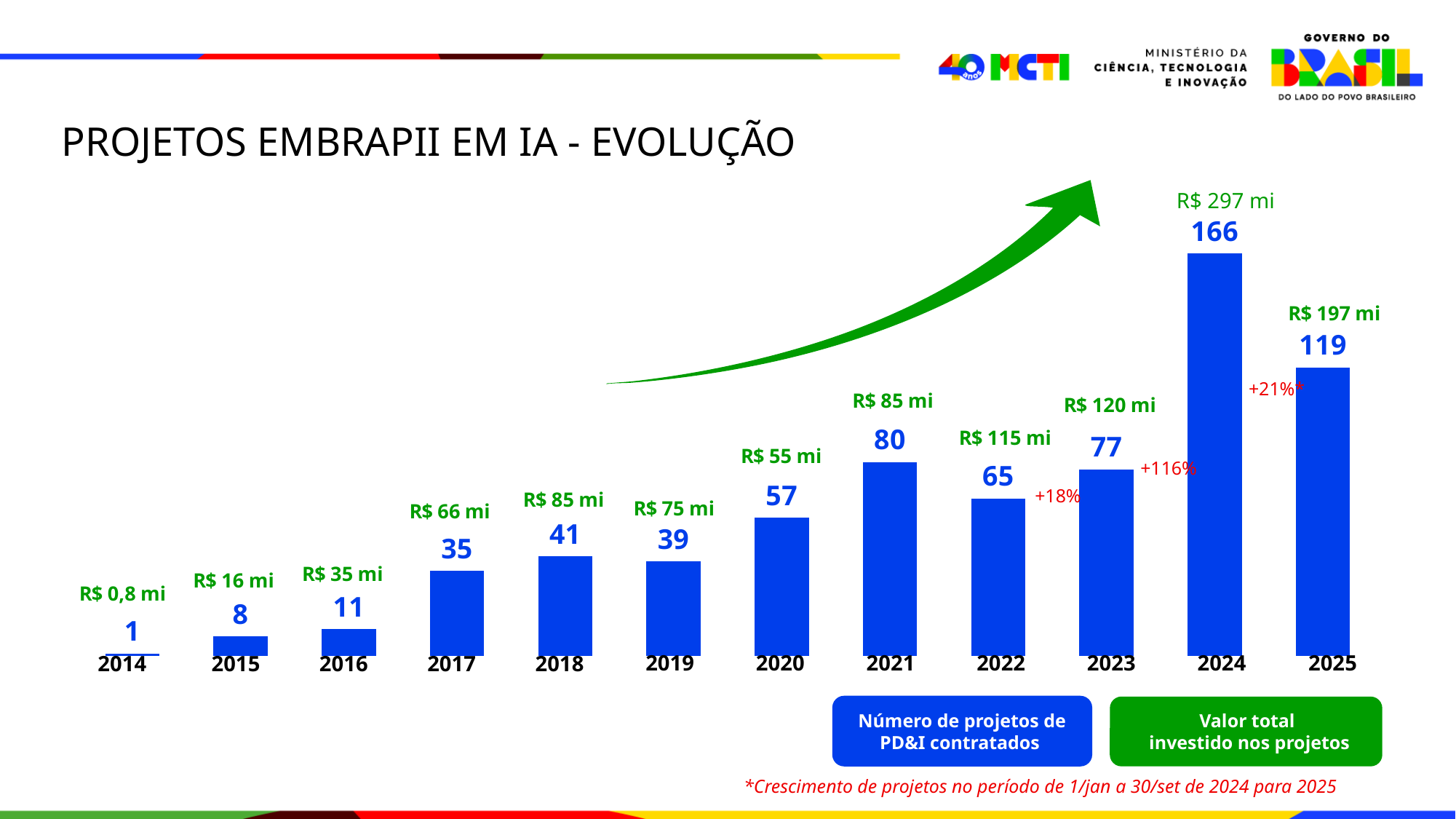
What was the total value invested in projects in 2023? R$ 120 mi What is the title of the slide containing the chart? PROJETOS EMBRAPII EM IA - EVOLUÇÃO What kind of chart is shown on the slide? bar chart Which year has the highest number of contracted projects? 2024 Overall, does the number of projects rise or fall from 2014 to 2024? rise What was the total value invested in projects in 2014? R$ 0,8 mi How many years are shown on the x axis of the chart? 12 Which year has the lowest number of contracted projects? 2014 How many projects were contracted in 2024? 166 What is the difference in the number of projects between 2024 and 2023? 89 How many projects were contracted in 2017? 35 Which year had more contracted projects, 2021 or 2022? 2021